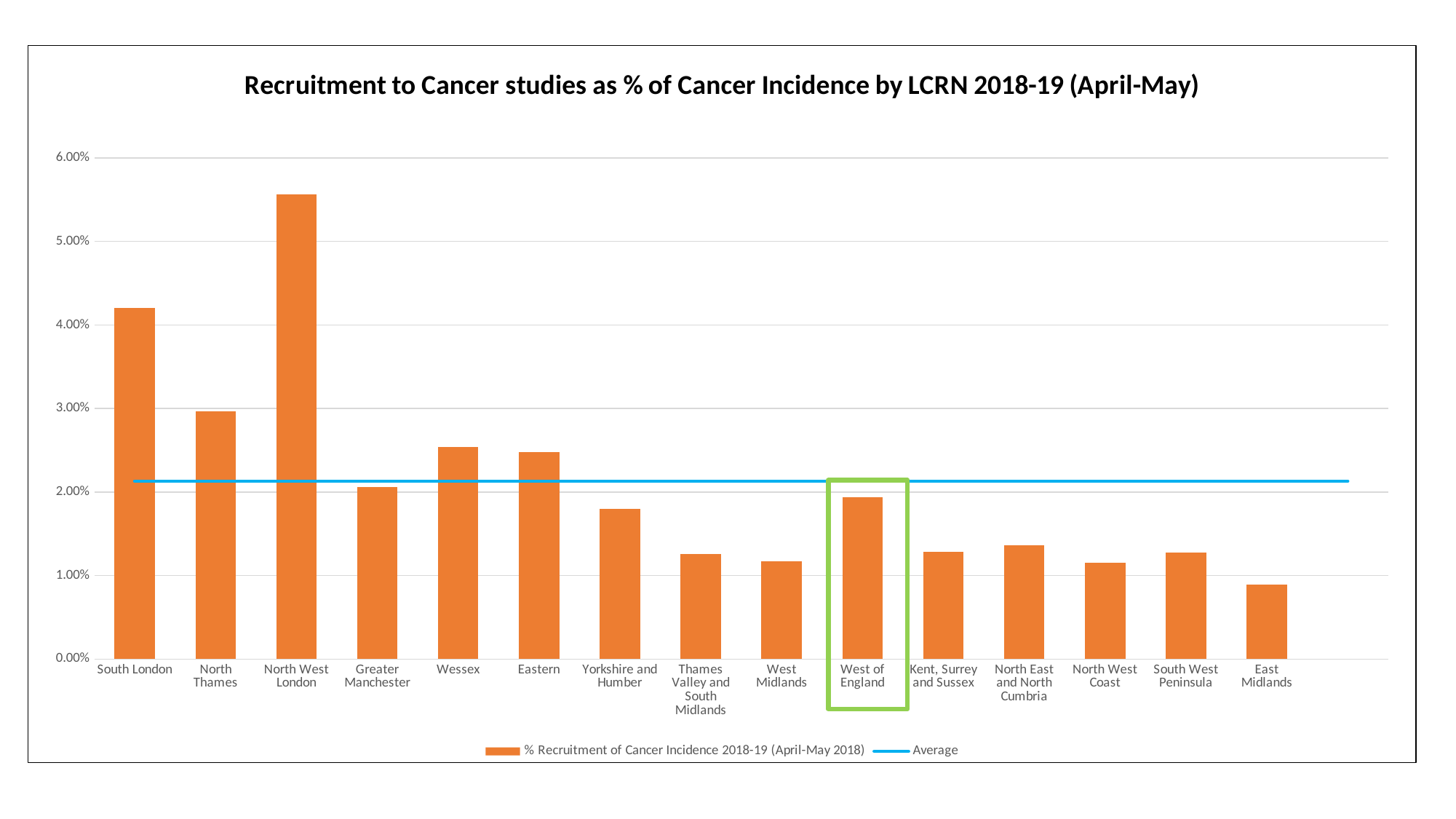
Is the value for Yorkshire and Humber greater or less than 2.00%? less Which is larger, the value for South London or the value for North Thames? South London How many LCRNs are shown on the x axis? 15 Is the value for East Midlands greater or less than 1.00%? less Is the value for South London greater or less than 4.00%? greater What kind of chart is shown on the slide? Bar chart Which LCRN has the lowest recruitment to cancer studies as % of cancer incidence? East Midlands What does the blue horizontal line on the chart represent, according to the legend? Average Which LCRN has the highest recruitment to cancer studies as % of cancer incidence? North West London Which is larger, the value for West of England or the value for West Midlands? West of England How many series does the legend list? 2